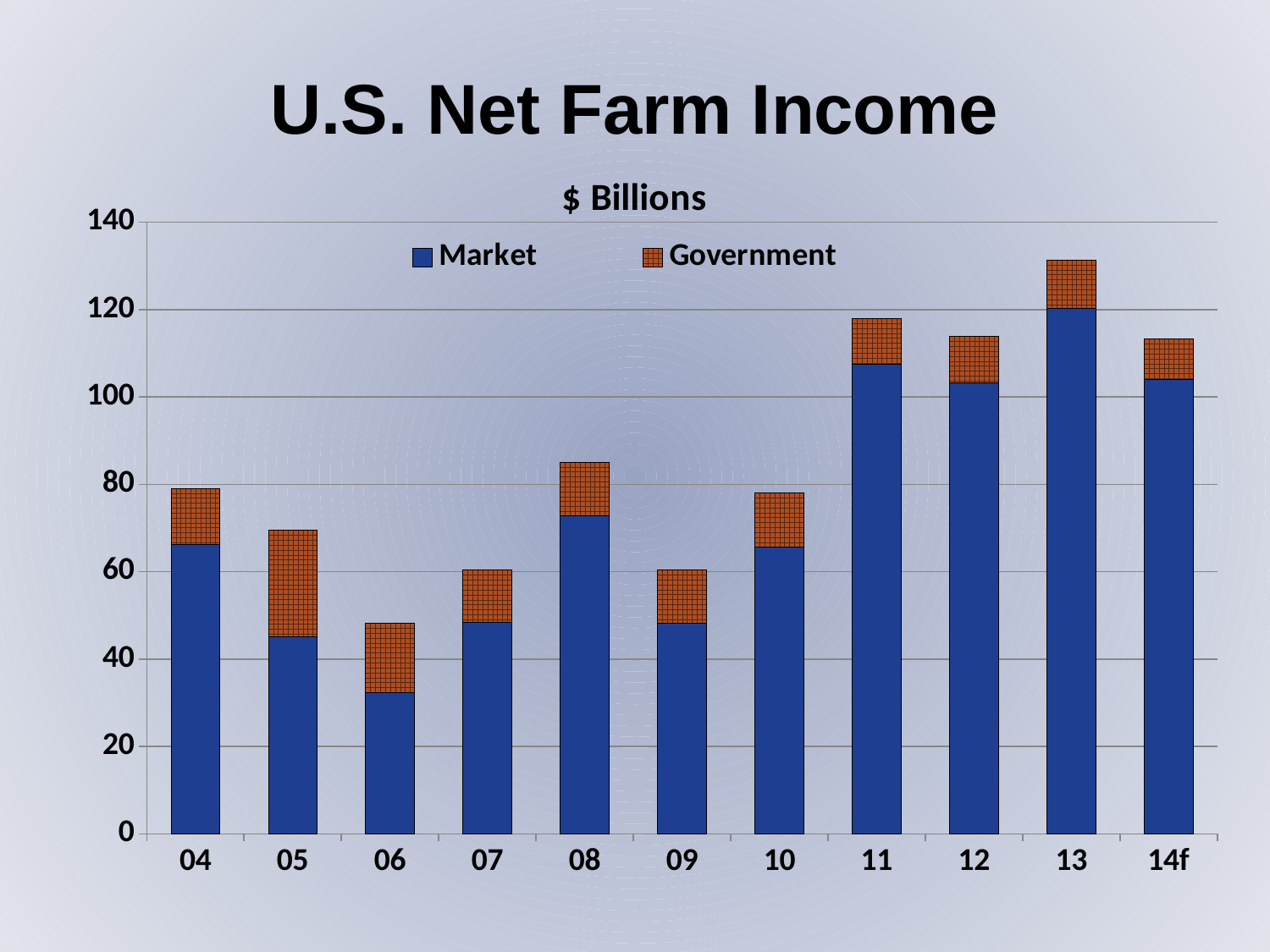
How many series does the legend list? 2 Is the Market value for 11 greater or less than 100? greater Which year has the highest total net farm income? 13 Which year has the larger total, 08 or 10? 08 Do the total values rise or fall from 06 to 08? rise Is the Market value for 06 greater or less than 40? less Is the total value for 13 greater or less than 120? greater What unit is given above the chart for the values? $ Billions What kind of chart is shown on the slide? Stacked bar chart How many years are shown on the x axis? 11 Which year has the lowest total net farm income? 06